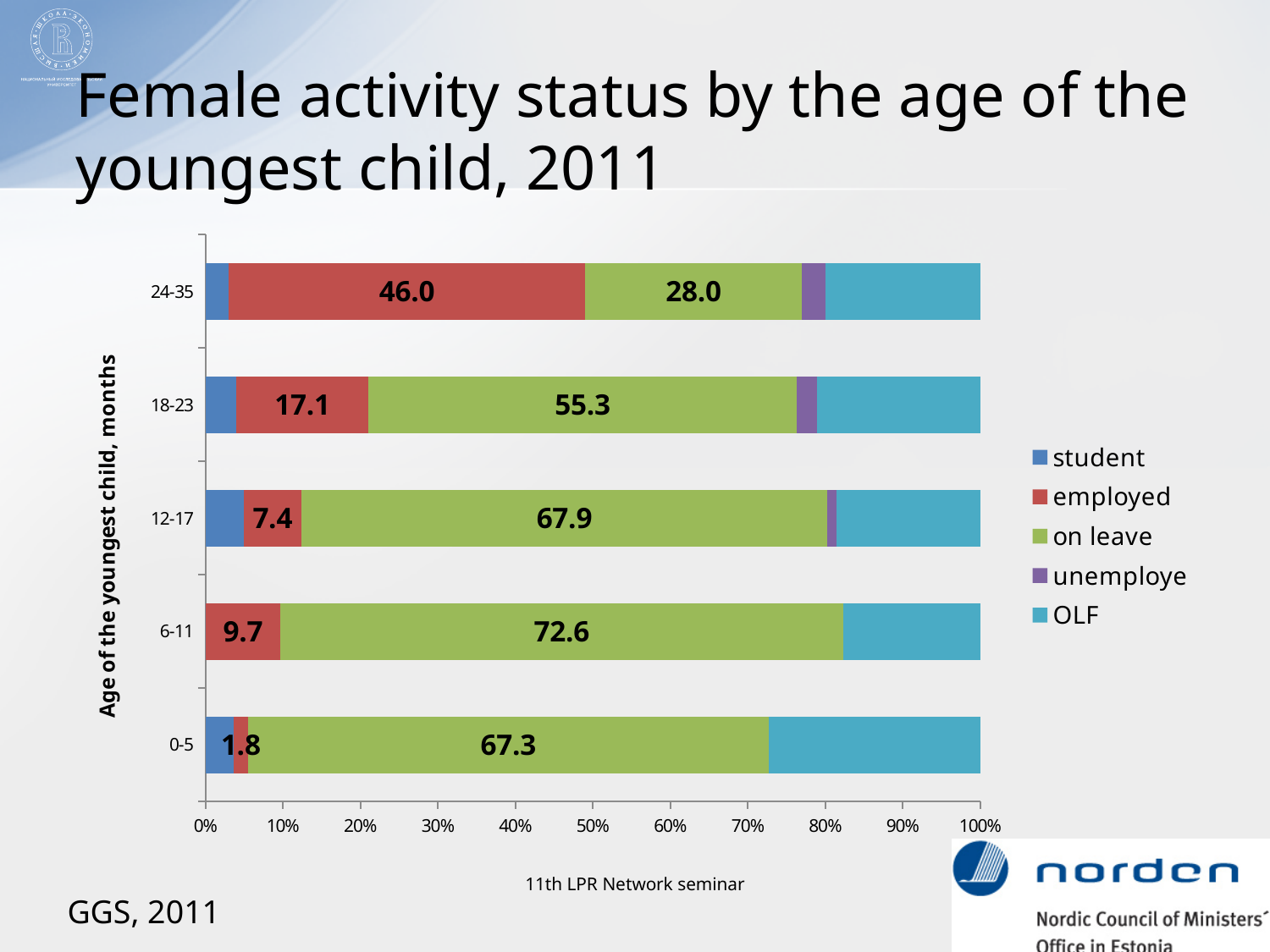
What is the employed share for the 24-35 months category? 46.0 Which age category has the lowest on leave share? 24-35 How many age categories are shown on the y axis? 5 What kind of chart is shown on the slide? Stacked bar chart What is the employed share for the 0-5 months category? 1.8 How many series does the legend list? 5 Which age category has the highest on leave share? 6-11 What is the difference between the on leave shares for 12-17 and 0-5 months? 0.6 Which age category has the highest employed share? 24-35 What is the on leave share for the 6-11 months category? 72.6 Which is larger, the employed share for 6-11 months or for 12-17 months? 6-11 Is the OLF share for the 0-5 months category greater or less than 20%? greater